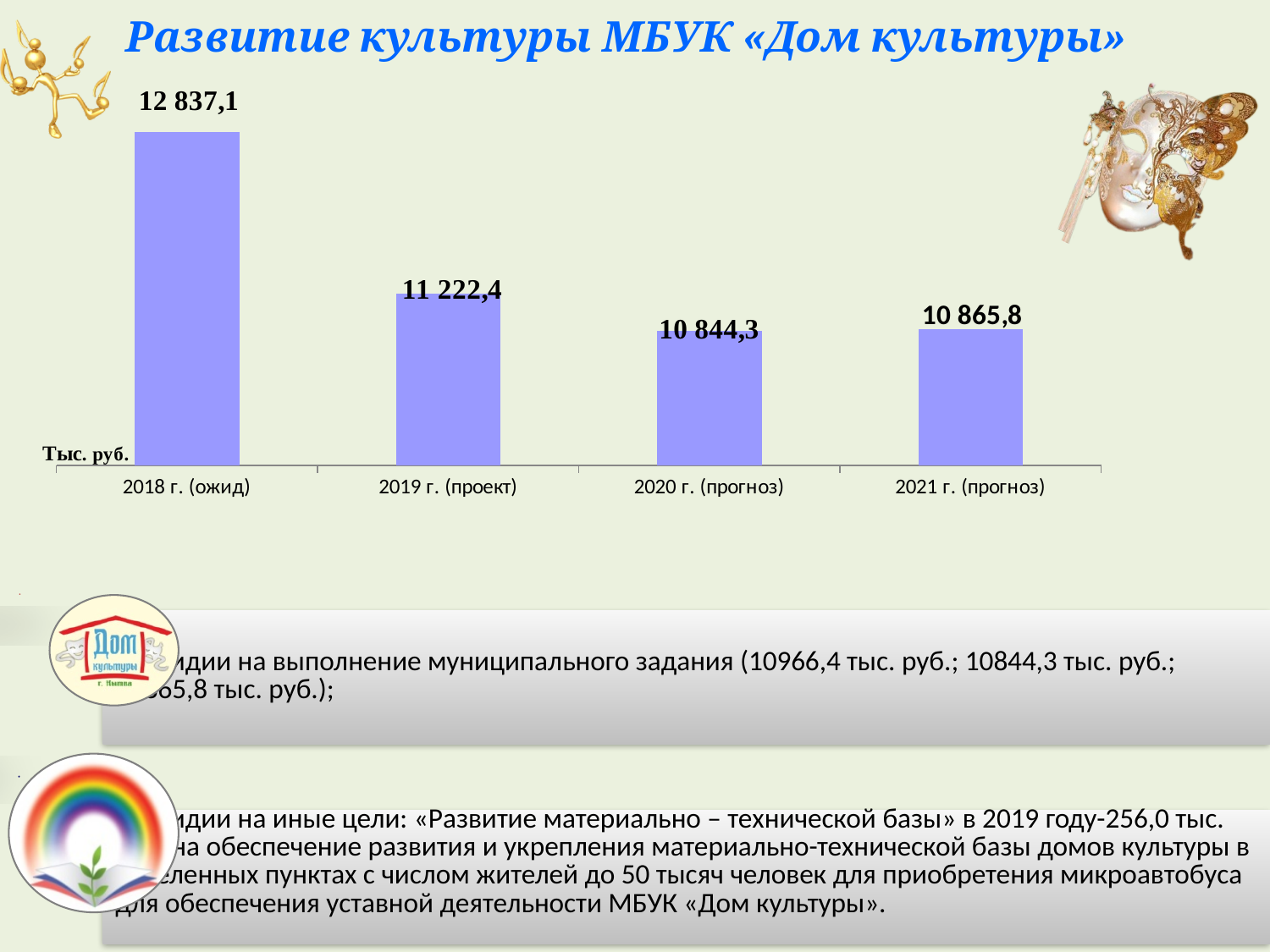
What is the difference between the values for 2021 г. (прогноз) and 2020 г. (прогноз)? 21,5 Do the values rise or fall from 2018 г. (ожид) to 2020 г. (прогноз)? Fall What is the value for 2020 г. (прогноз)? 10 844,3 Which category has the lowest value? 2020 г. (прогноз) How many categories are shown on the x axis? 4 What is the value for 2018 г. (ожид)? 12 837,1 Which category has the highest value? 2018 г. (ожид) What is the difference between the values for 2018 г. (ожид) and 2019 г. (проект)? 1 614,7 Which is larger, the value for 2019 г. (проект) or the value for 2021 г. (прогноз)? 2019 г. (проект) What kind of chart is shown on the slide? Bar chart What is the value for 2019 г. (проект)? 11 222,4 What is the value for 2021 г. (прогноз)? 10 865,8